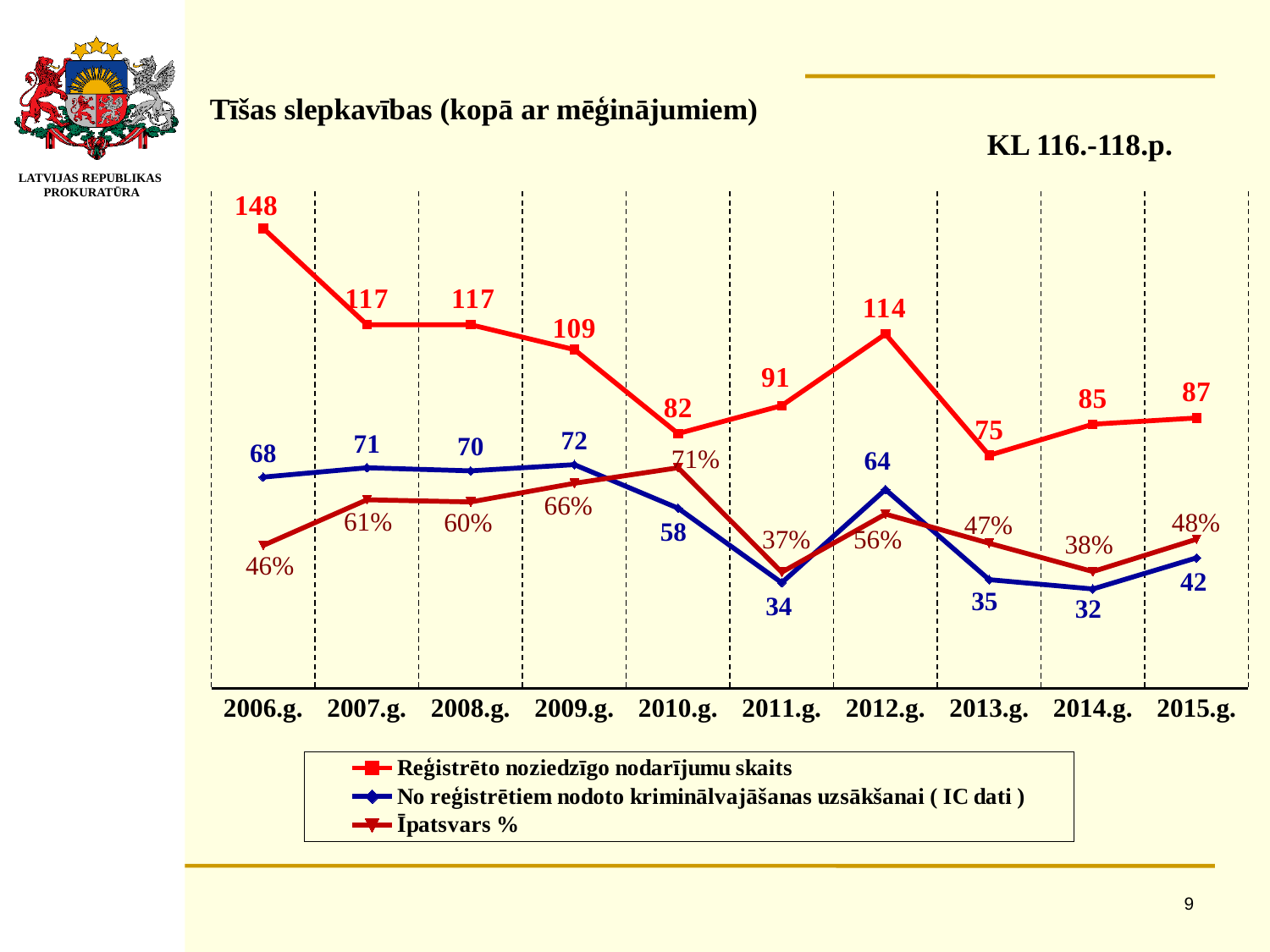
How many series does the legend list? 3 What is the difference between 'Reģistrēto noziedzīgo nodarījumu skaits' in 2006.g. and in 2015.g.? 61 What is the title of the chart? Tīšas slepkavības (kopā ar mēģinājumiem) Which is larger: 'Reģistrēto noziedzīgo nodarījumu skaits' in 2012.g. or in 2009.g.? 2012.g. What is the 'Īpatsvars %' value for 2010.g.? 71% How many years are shown on the x axis? 10 What is the value of 'Reģistrēto noziedzīgo nodarījumu skaits' in 2006.g.? 148 In which year is 'No reģistrētiem nodoto kriminālvajāšanas uzsākšanai ( IC dati )' lowest? 2014.g. What type of chart is shown on the slide? line chart What is the value of 'No reģistrētiem nodoto kriminālvajāšanas uzsākšanai ( IC dati )' in 2012.g.? 64 In which year is 'Reģistrēto noziedzīgo nodarījumu skaits' lowest? 2013.g. In which year is 'Īpatsvars %' highest? 2010.g.